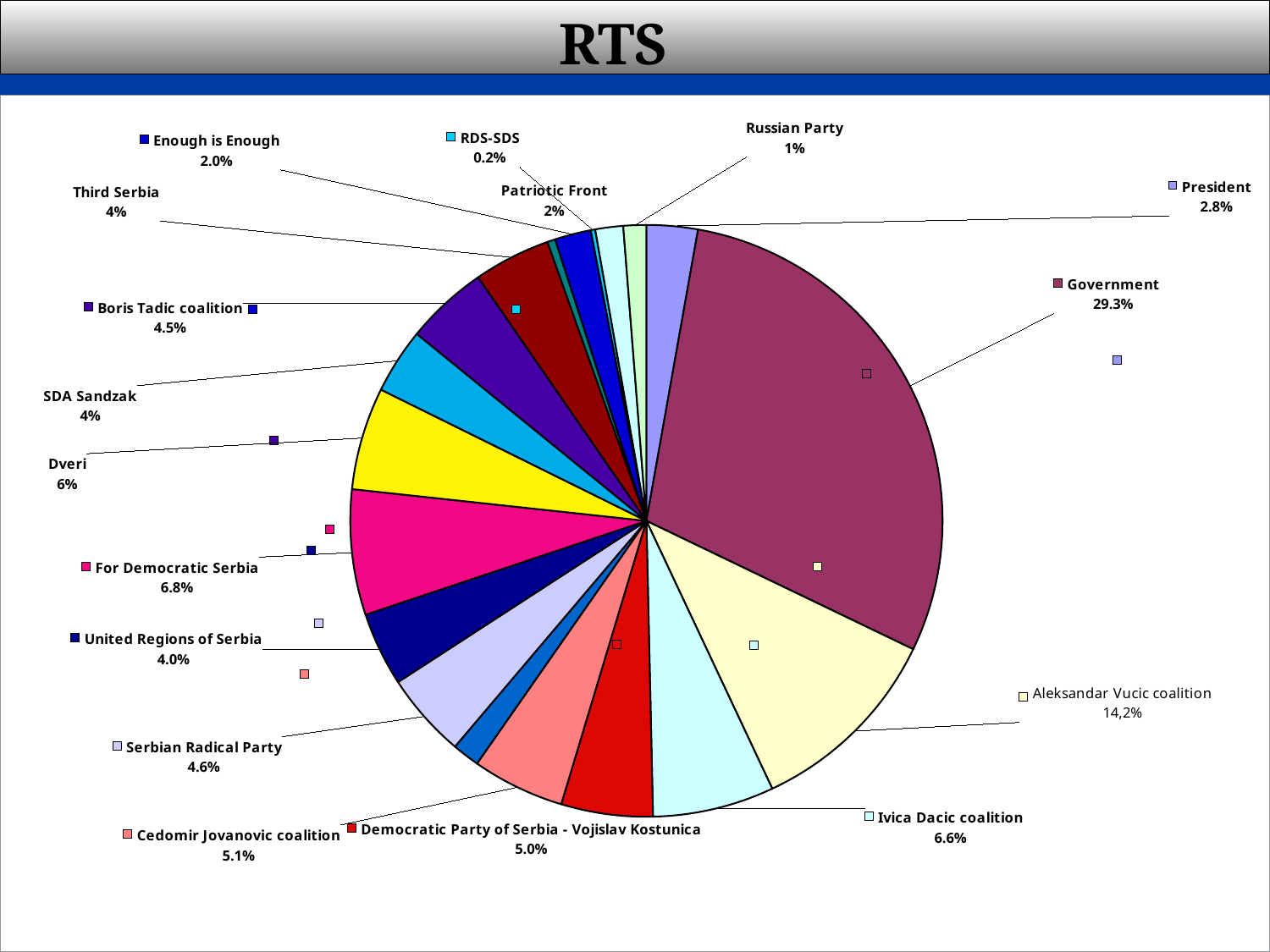
What is the title of the slide containing the pie chart? RTS What percentage is shown for Ivica Dacic coalition? 6.6% What share of the pie does Government hold? 29.3% What is the difference between the Cedomir Jovanovic coalition value and the Democratic Party of Serbia - Vojislav Kostunica value? 0.1% Which is larger, the slice for For Democratic Serbia or the slice for Dveri? For Democratic Serbia What is the difference between the Government share and the Aleksandar Vucic coalition share? 15.1% What is the value shown for Aleksandar Vucic coalition? 14,2% Which category has the smallest slice of the pie? RDS-SDS What is the value for Serbian Radical Party? 4.6% How many slices does the pie chart have? 19 Which category has the largest slice of the pie? Government What type of chart is shown on the slide? pie chart